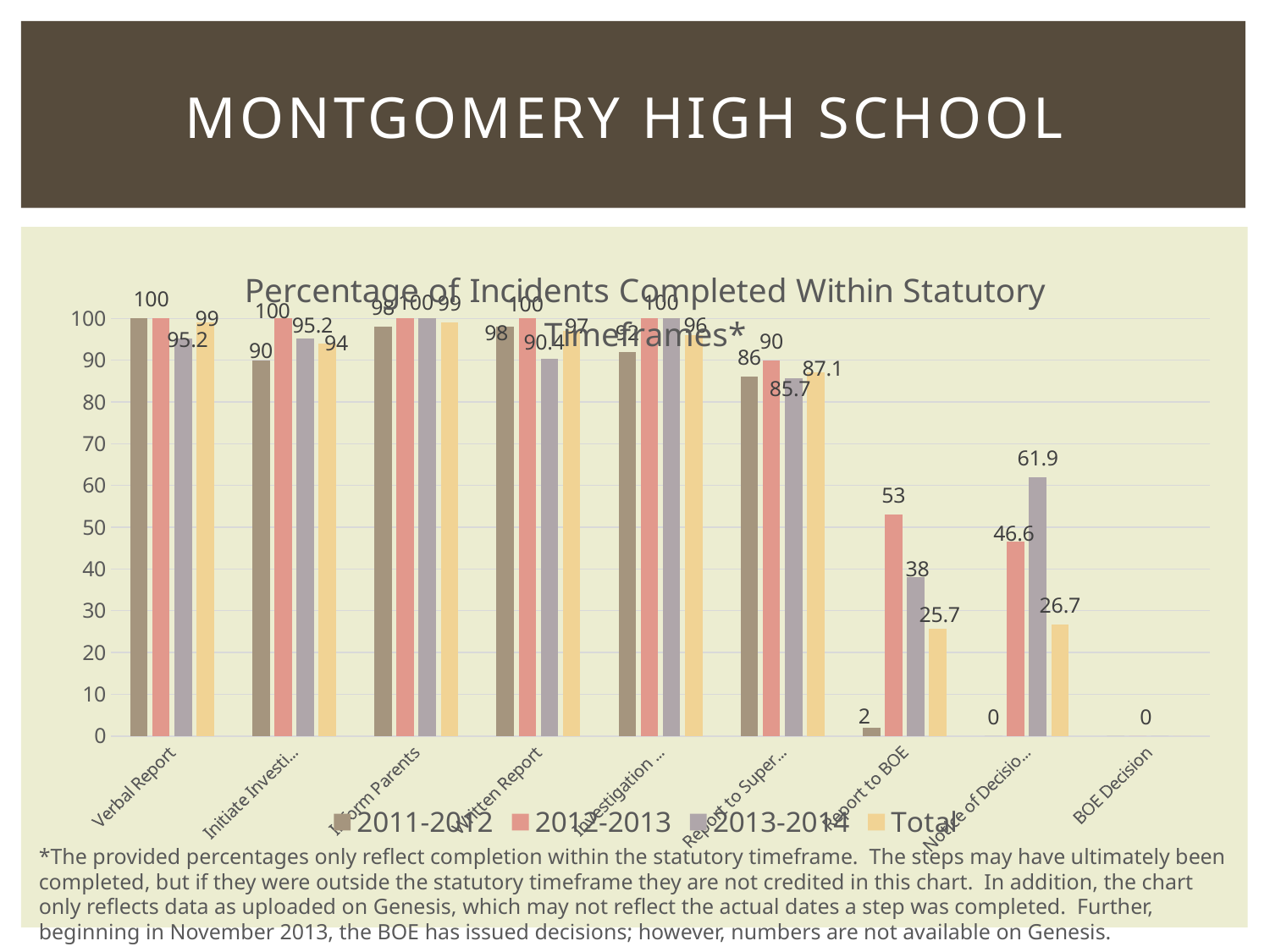
For Report to Super..., which is larger: the 2011-2012 value or the 2012-2013 value? 2012-2013 What kind of chart is shown on the slide? bar chart What is the Total value for Report to BOE? 25.7 What is the Total value for Report to Super...? 87.1 What is the 2012-2013 value for Report to BOE? 53 How many categories are shown along the x axis? 9 What are the four entries listed in the legend? 2011-2012, 2012-2013, 2013-2014, Total What is the difference between the 2012-2013 and 2013-2014 values for Report to BOE? 15 How many series does the legend list? 4 Is the 2011-2012 value for Report to BOE greater or less than 10? less Which series has the highest value for Notice of Decision? 2013-2014 What is the 2013-2014 value for Notice of Decision? 61.9